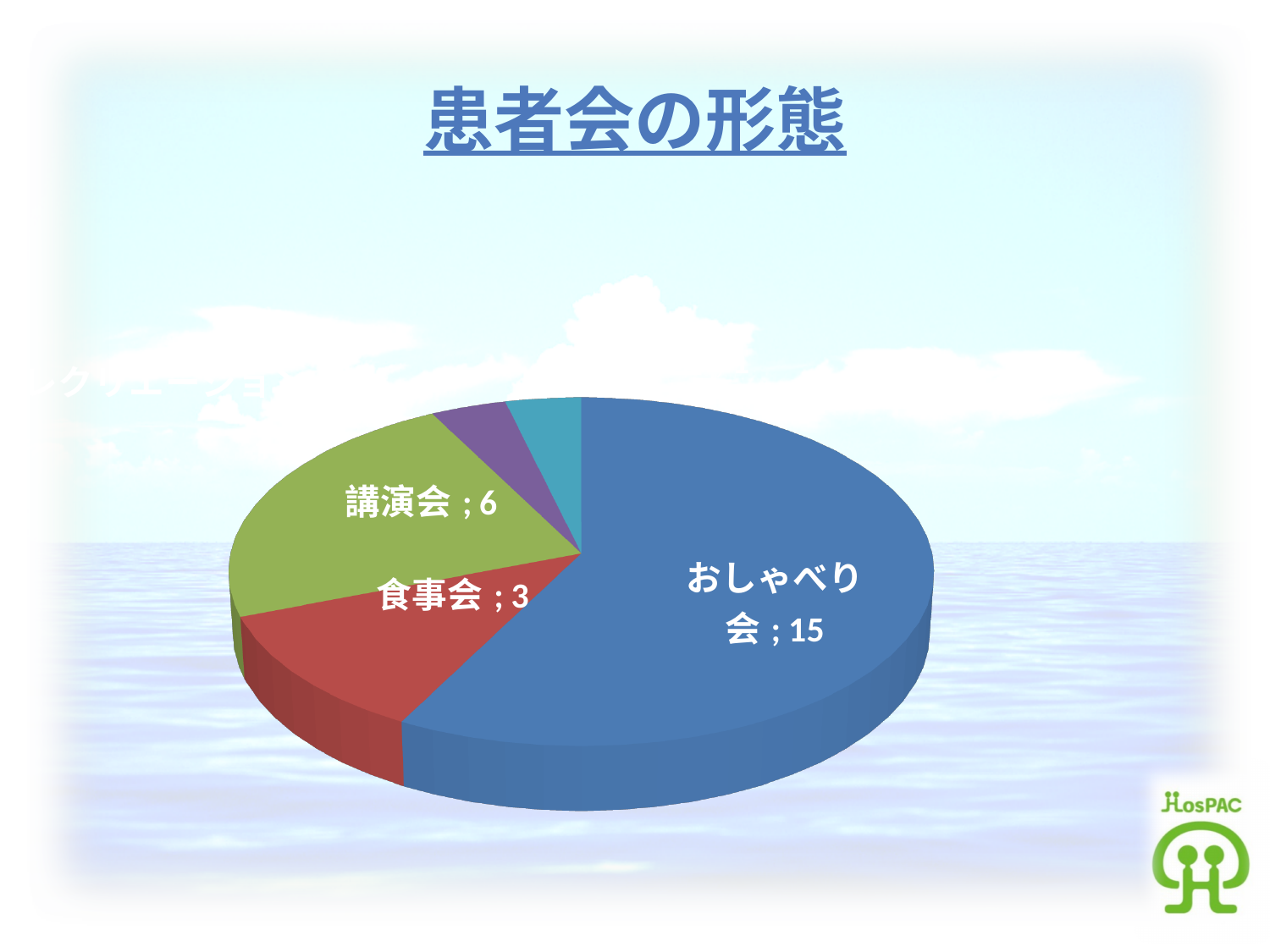
What is the title of the chart? 患者会の形態 What is the difference between the values for おしゃべり会 and 講演会? 9 Which is larger, the value for 食事会 or the value for 講演会? 講演会 What is the value for 食事会? 3 How many slices does the pie chart have? 5 What is the value for 講演会? 6 What is the value for おしゃべり会? 15 Which is larger, the value for おしゃべり会 or the value for 食事会? おしゃべり会 What is the difference between the values for 講演会 and 食事会? 3 What colour is the slice for おしゃべり会? blue Which category has the largest slice of the pie? おしゃべり会 What kind of chart is shown on the slide? pie chart